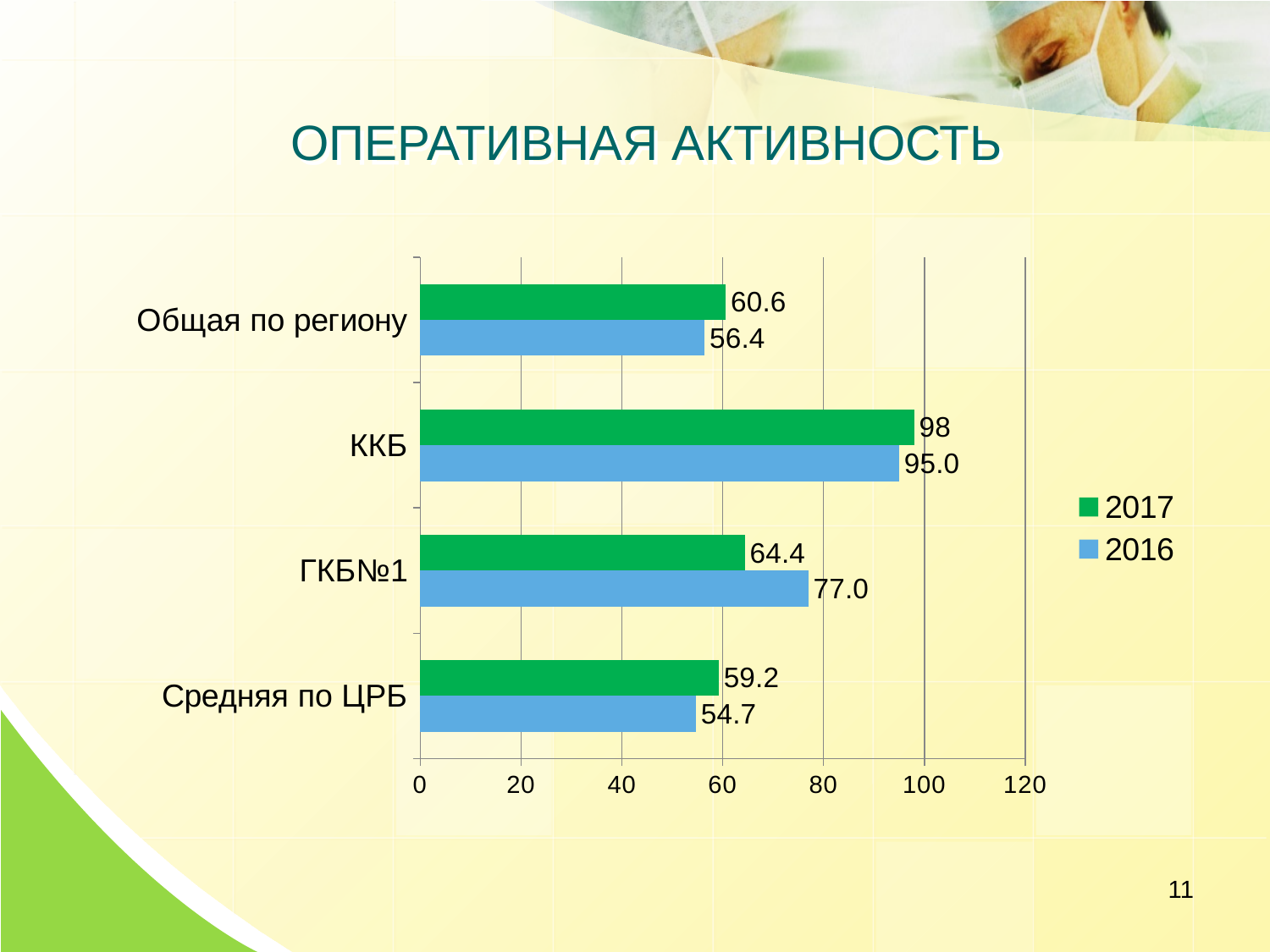
What is the title of the slide? ОПЕРАТИВНАЯ АКТИВНОСТЬ How many categories are shown on the chart? 4 For Общая по региону, which year has the larger value, 2016 or 2017? 2017 What kind of chart is shown on the slide? Bar chart Which category has the highest 2017 value? ККБ Which category has the lowest 2016 value? Средняя по ЦРБ How many series does the legend list? 2 What is the difference between the 2016 and 2017 values for ГКБ№1? 12.6 What is the 2017 value for Средняя по ЦРБ? 59.2 What is the 2016 value for Общая по региону? 56.4 What is the 2016 value for ГКБ№1? 77.0 What is the 2017 value for ККБ? 98